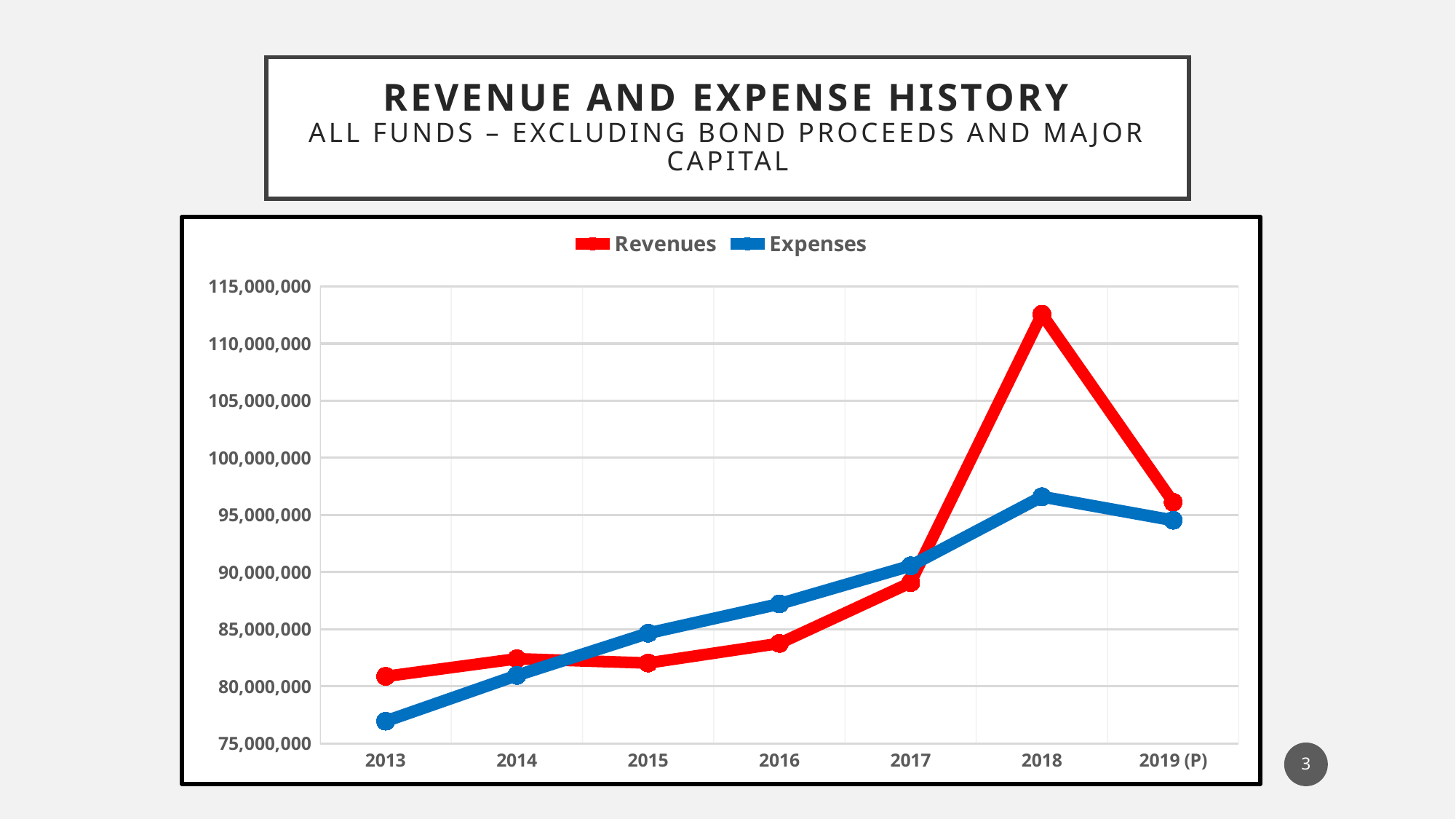
How many series does the legend list? 2 In 2016, which is larger, Revenues or Expenses? Expenses In which year are Revenues highest? 2018 In which year are Revenues lowest? 2013 Do Expenses rise or fall from 2013 to 2018? Rise In 2018, which is larger, Revenues or Expenses? Revenues What kind of chart is shown on the slide? Line chart Is the value for Revenues in 2018 greater or less than 110,000,000? greater In which year are Expenses highest? 2018 In which year are Expenses lowest? 2013 Is the value for Expenses in 2013 greater or less than 80,000,000? less How many years are plotted along the x axis? 7